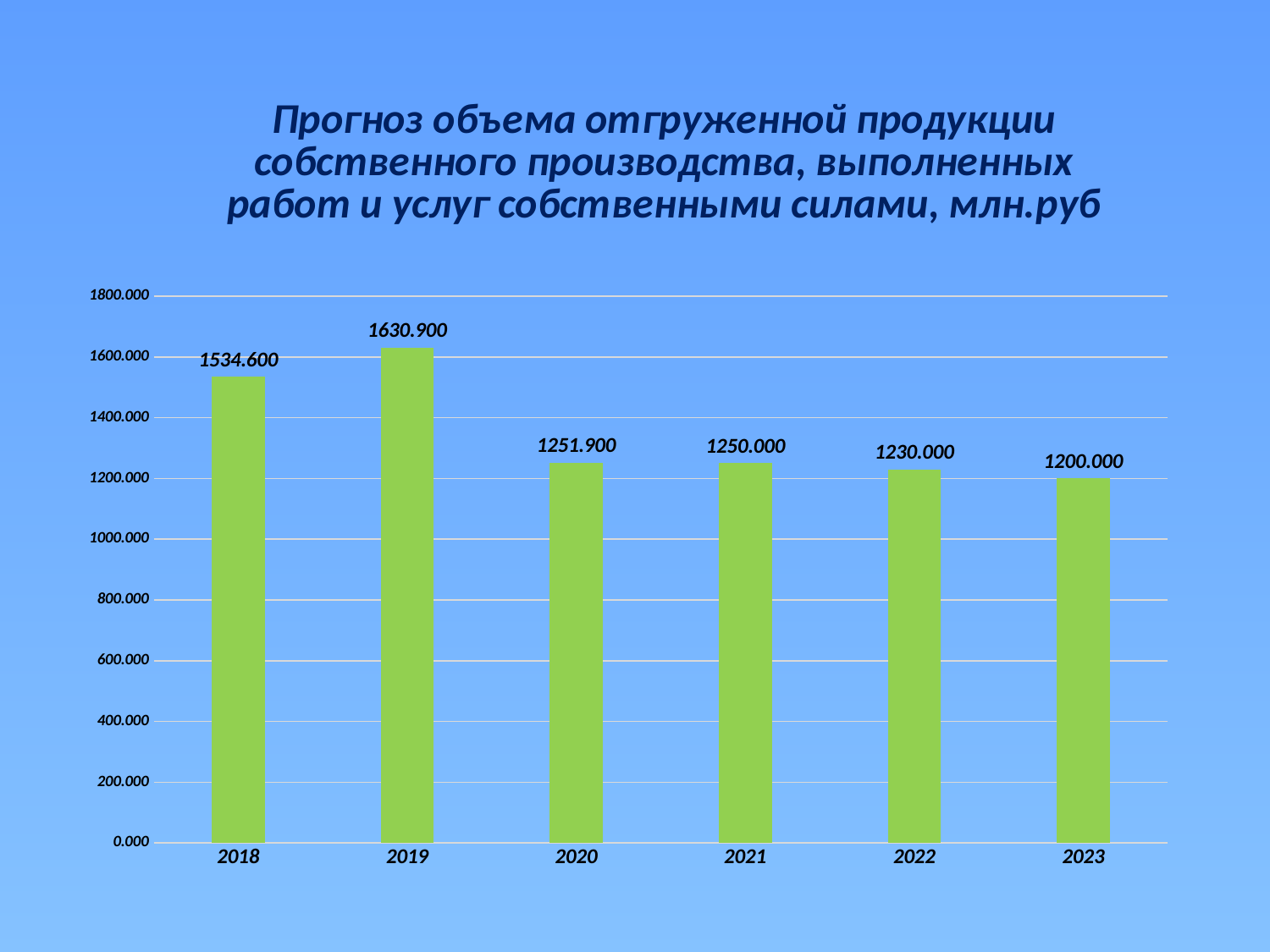
How many years are shown on the x axis? 6 What is the difference between the values for 2022 and 2023? 30.000 What is the value for 2018? 1534.600 What is the value for 2023? 1200.000 Which is larger, the value for 2018 or the value for 2023? 2018 From 2019 to 2023, do the values rise or fall? fall What kind of chart is shown on the slide? bar chart Which year has the lowest value? 2023 What is the value for 2019? 1630.900 Which year has the highest value? 2019 Is the value for 2020 greater or less than 1400.000? less What is the difference between the values for 2019 and 2018? 96.300